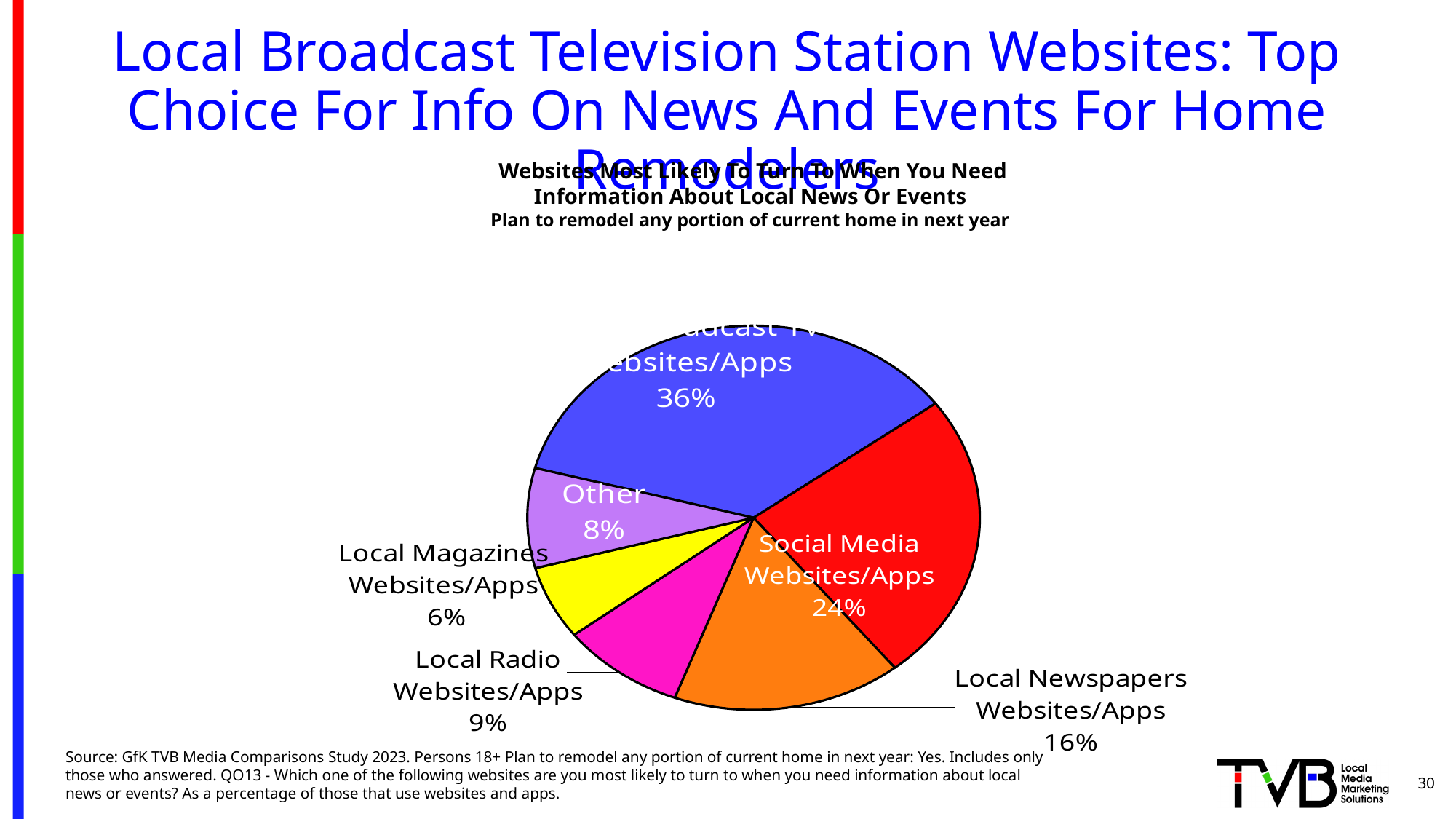
What colour is the Social Media Websites/Apps slice? Red What is the difference in percentage points between Social Media Websites/Apps and Local Newspapers Websites/Apps? 8 percentage points What type of chart is shown on the slide? Pie chart What share of the pie is Local Radio Websites/Apps? 9% Which is larger, Local Radio Websites/Apps or Other? Local Radio Websites/Apps What share of the pie is Local Magazines Websites/Apps? 6% What share of the pie is Local Newspapers Websites/Apps? 16% What percentage is shown for the largest slice of the pie? 36% How many slices does the pie chart have? 6 What share of the pie is the Other slice? 8% What share of the pie is Social Media Websites/Apps? 24% Which category has the smallest slice of the pie? Local Magazines Websites/Apps